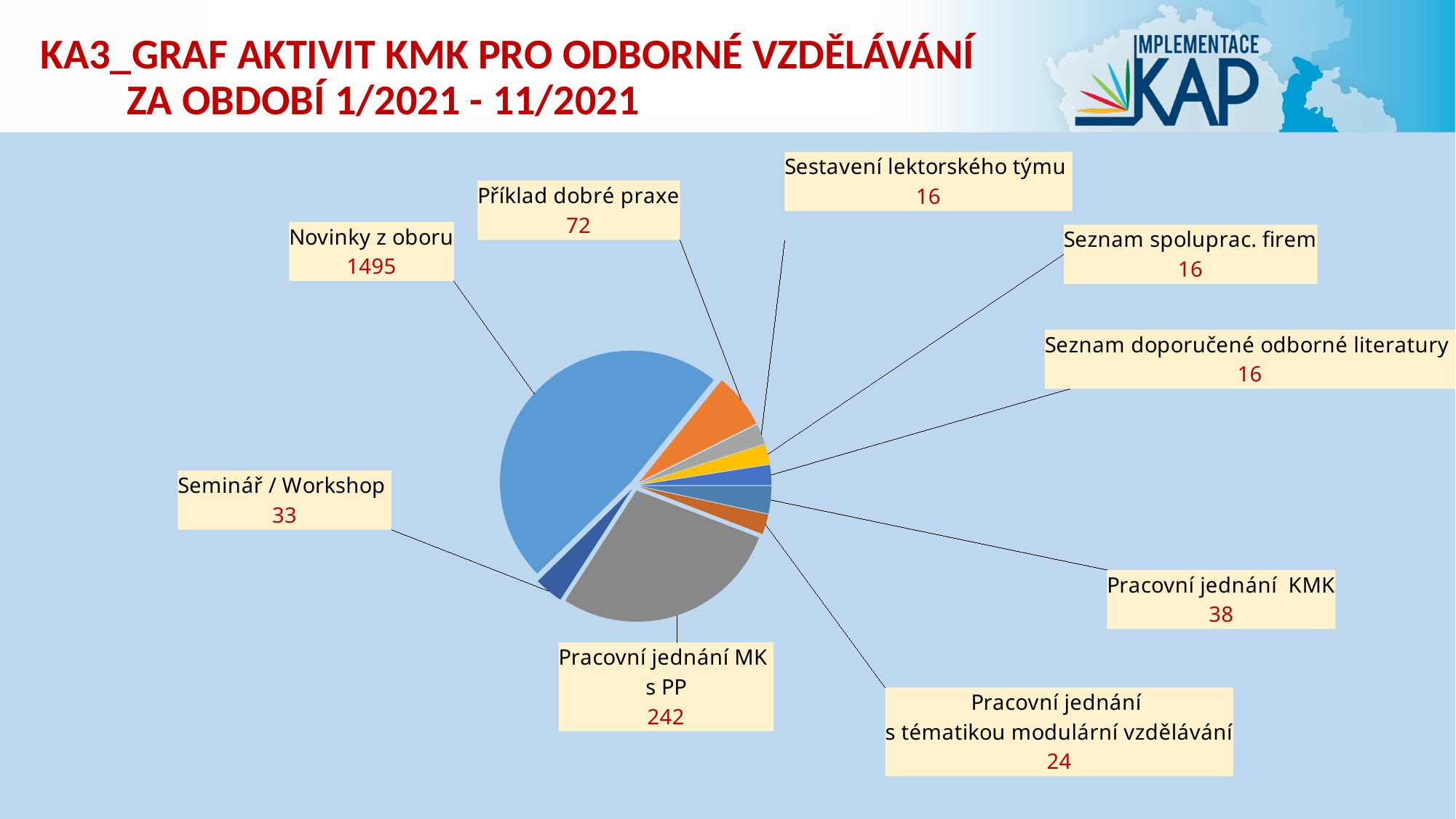
What is the value for Pracovní jednání s tématikou modulární vzdělávání? 24 What is the value for Pracovní jednání KMK? 38 What is the value for Seminář / Workshop? 33 Which is larger, Pracovní jednání KMK or Seminář / Workshop? Pracovní jednání KMK What is the value for Příklad dobré praxe? 72 Which category has the highest value? Novinky z oboru What period does the chart title say the data covers? 1/2021 - 11/2021 What is the value for Pracovní jednání MK s PP? 242 What type of chart is shown on the slide? pie chart What is the difference between Novinky z oboru and Pracovní jednání MK s PP? 1253 How many categories are shown in the pie chart? 9 What is the value for Novinky z oboru? 1495